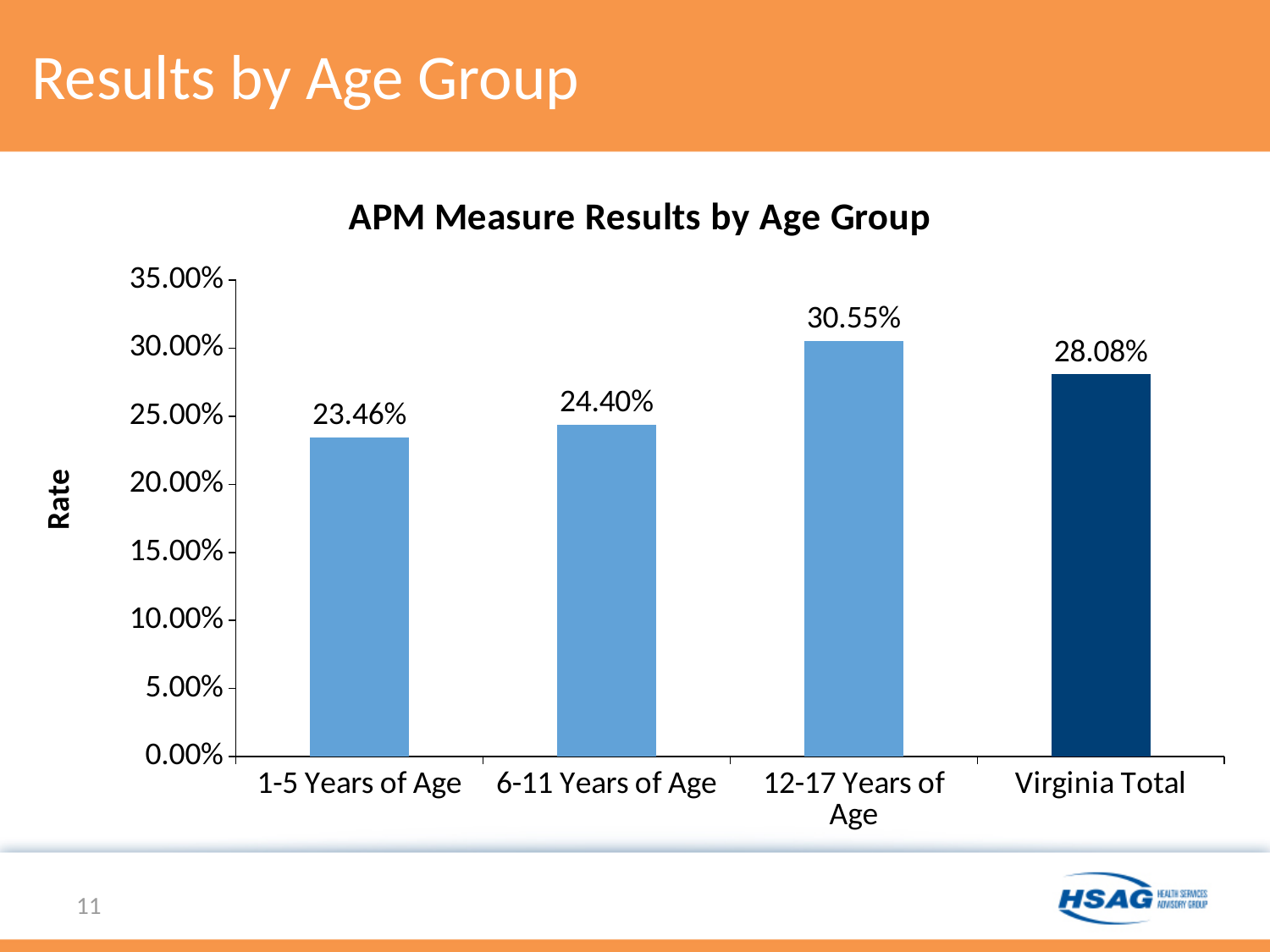
What is the value for 1-5 Years of Age? 23.46% Which is larger, the value for Virginia Total or the value for 6-11 Years of Age? Virginia Total Is the value for 12-17 Years of Age greater or less than 30.00%? greater What is the value for 12-17 Years of Age? 30.55% What kind of chart is shown? bar chart Which category has the highest value? 12-17 Years of Age What is the value for Virginia Total? 28.08% What is the value for 6-11 Years of Age? 24.40% Which category has the lowest value? 1-5 Years of Age What is the title of the chart? APM Measure Results by Age Group How many categories are shown on the x axis? 4 What is the difference between the values for 12-17 Years of Age and 1-5 Years of Age? 7.09%